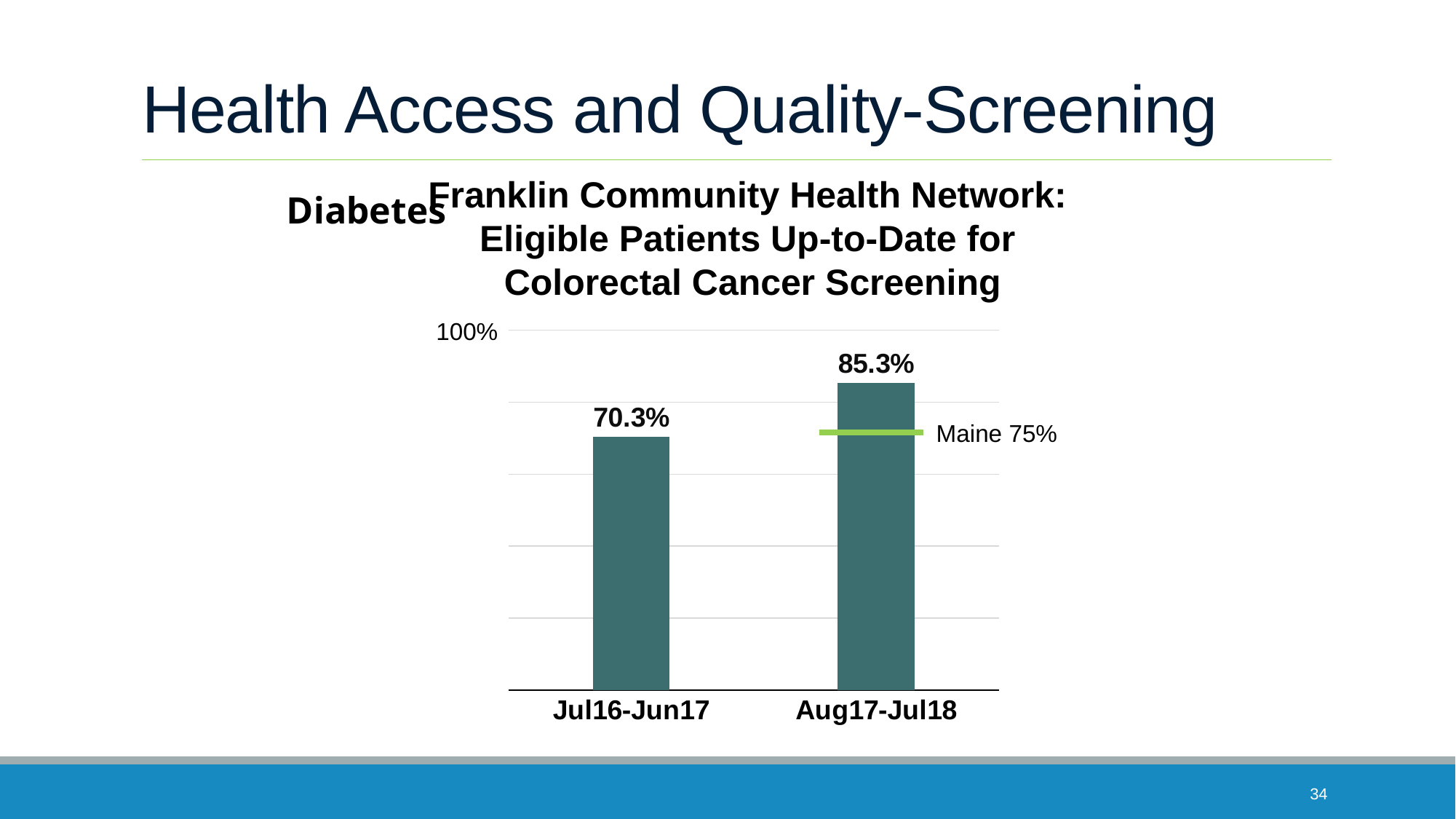
How many periods are shown on the x axis? 2 Which period has the highest value? Aug17-Jul18 What is the value for Jul16-Jun17? 70.3% What is the highest value shown on the y axis? 100% What is the value for Aug17-Jul18? 85.3% Do the values rise or fall from Jul16-Jun17 to Aug17-Jul18? Rise What is the difference between the Aug17-Jul18 and Jul16-Jun17 values? 15.0% What kind of chart is this? Bar chart What is the Maine benchmark value marked on the chart? 75% What is the title of the chart? Franklin Community Health Network: Eligible Patients Up-to-Date for Colorectal Cancer Screening Which period has the lowest value? Jul16-Jun17 Which is larger, the value for Jul16-Jun17 or Aug17-Jul18? Aug17-Jul18